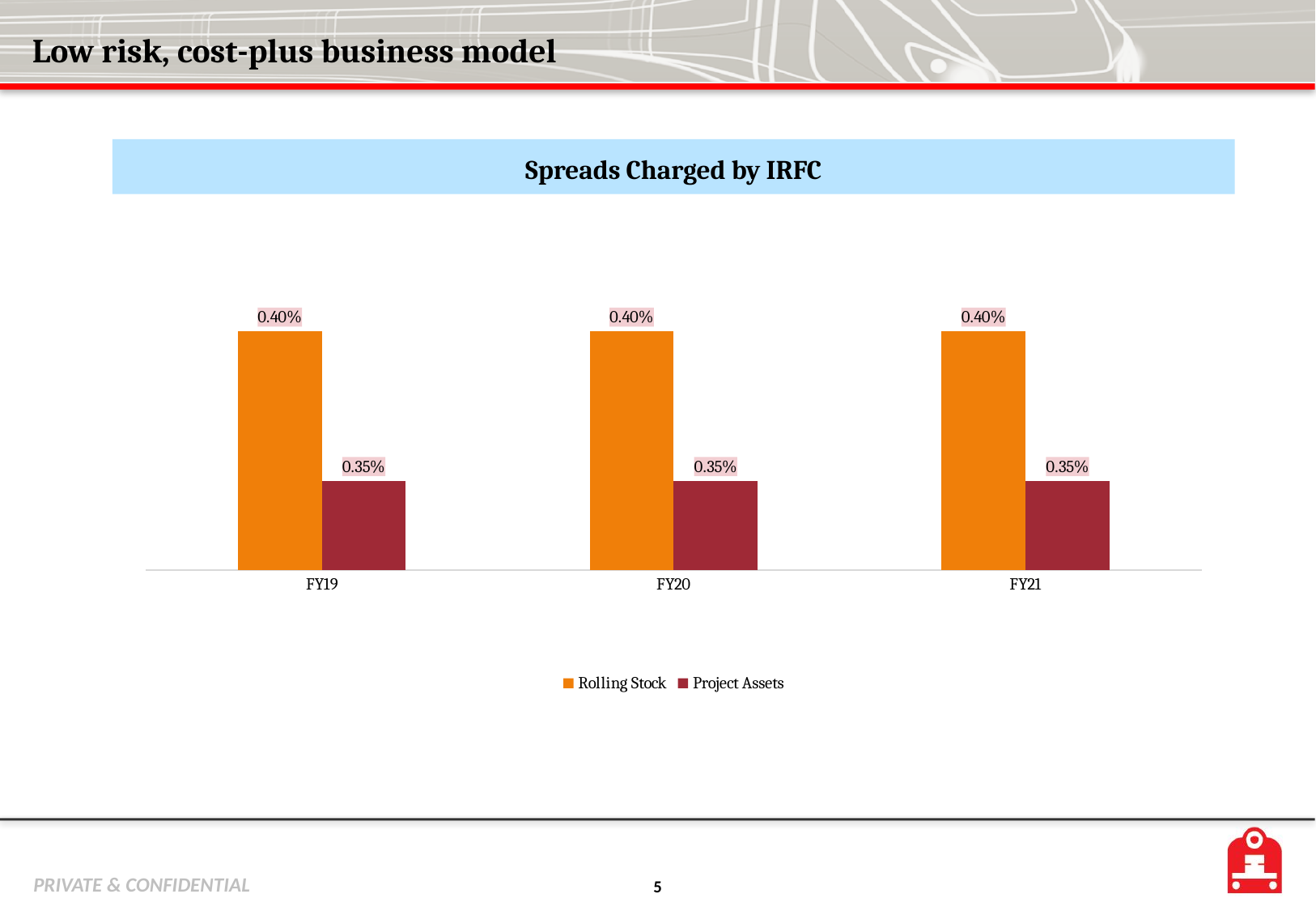
How many series does the legend list? 2 What is the title of the chart? Spreads Charged by IRFC What is the difference between the Rolling Stock and Project Assets spreads in FY20? 0.05% Does the Rolling Stock spread rise, fall or stay flat from FY19 to FY21? Stays flat What is the Rolling Stock spread in FY19? 0.40% What is the Project Assets spread in FY21? 0.35% Which series has the higher spread in FY19, Rolling Stock or Project Assets? Rolling Stock What is the Project Assets spread in FY20? 0.35% Which colour represents Project Assets in the chart? Dark red What kind of chart is shown on the slide? Bar chart What is the Rolling Stock spread in FY21? 0.40% How many fiscal years are shown on the x axis? 3